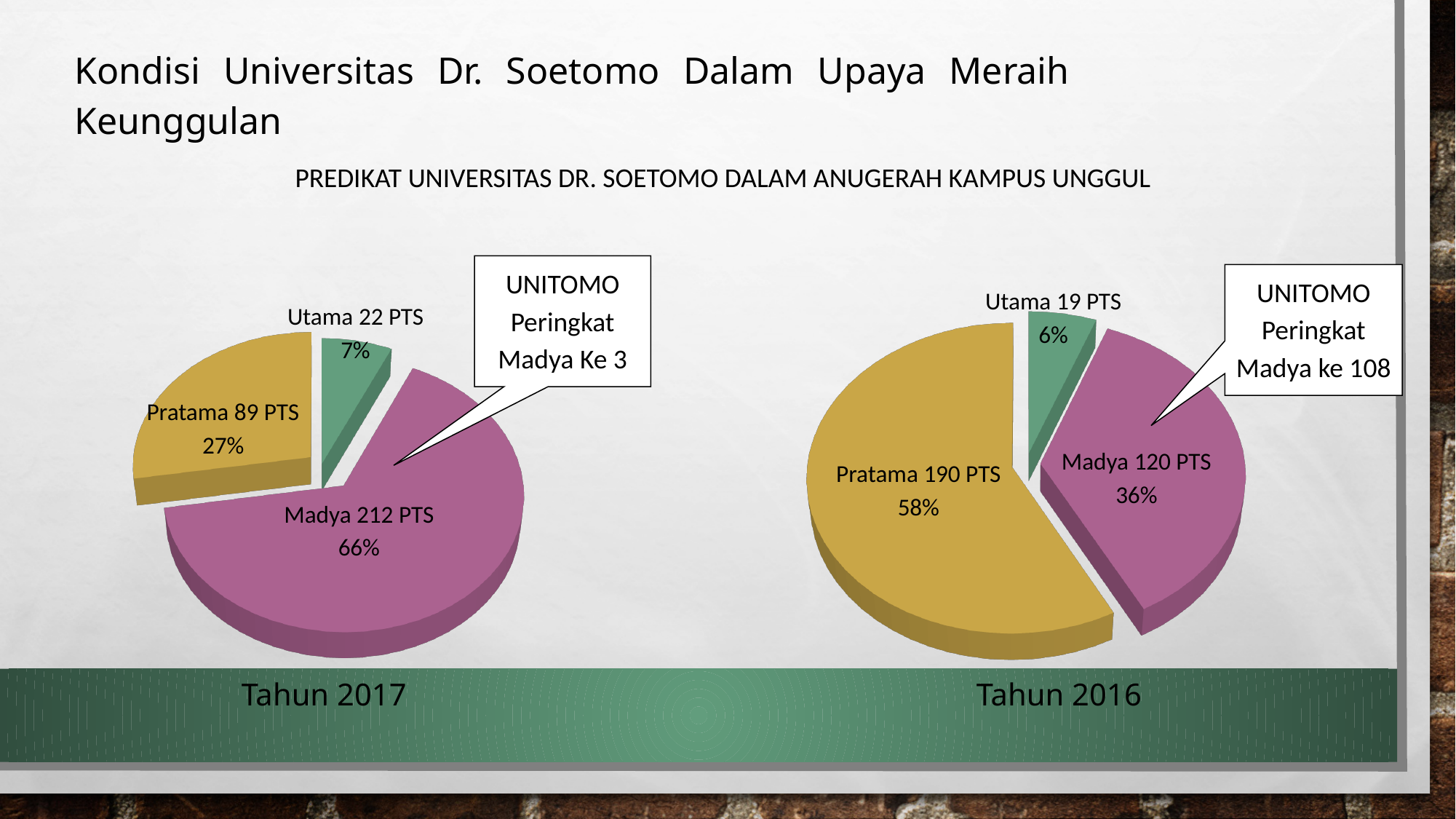
What kind of chart is used for Tahun 2017? Pie chart Which is larger: Utama PTS in the Tahun 2017 chart or Utama PTS in the Tahun 2016 chart? Tahun 2017 In the Tahun 2017 chart, which category has the smallest slice? Utama In the Tahun 2017 chart, what is the difference in PTS between Madya and Pratama? 123 PTS In the Tahun 2017 chart, what share of the pie does Pratama hold? 27% How many categories are shown in the Tahun 2016 chart? 3 In the Tahun 2016 chart, how many PTS are in the Pratama category? 190 PTS In the Tahun 2016 chart, which category has the largest slice? Pratama In the Tahun 2017 chart, what does the callout box say about UNITOMO's ranking? UNITOMO Peringkat Madya Ke 3 In the Tahun 2016 chart, what share of the pie does Madya hold? 36% In the Tahun 2016 chart, what is the difference in PTS between Pratama and Madya? 70 PTS In the Tahun 2017 chart, how many PTS are in the Madya category? 212 PTS